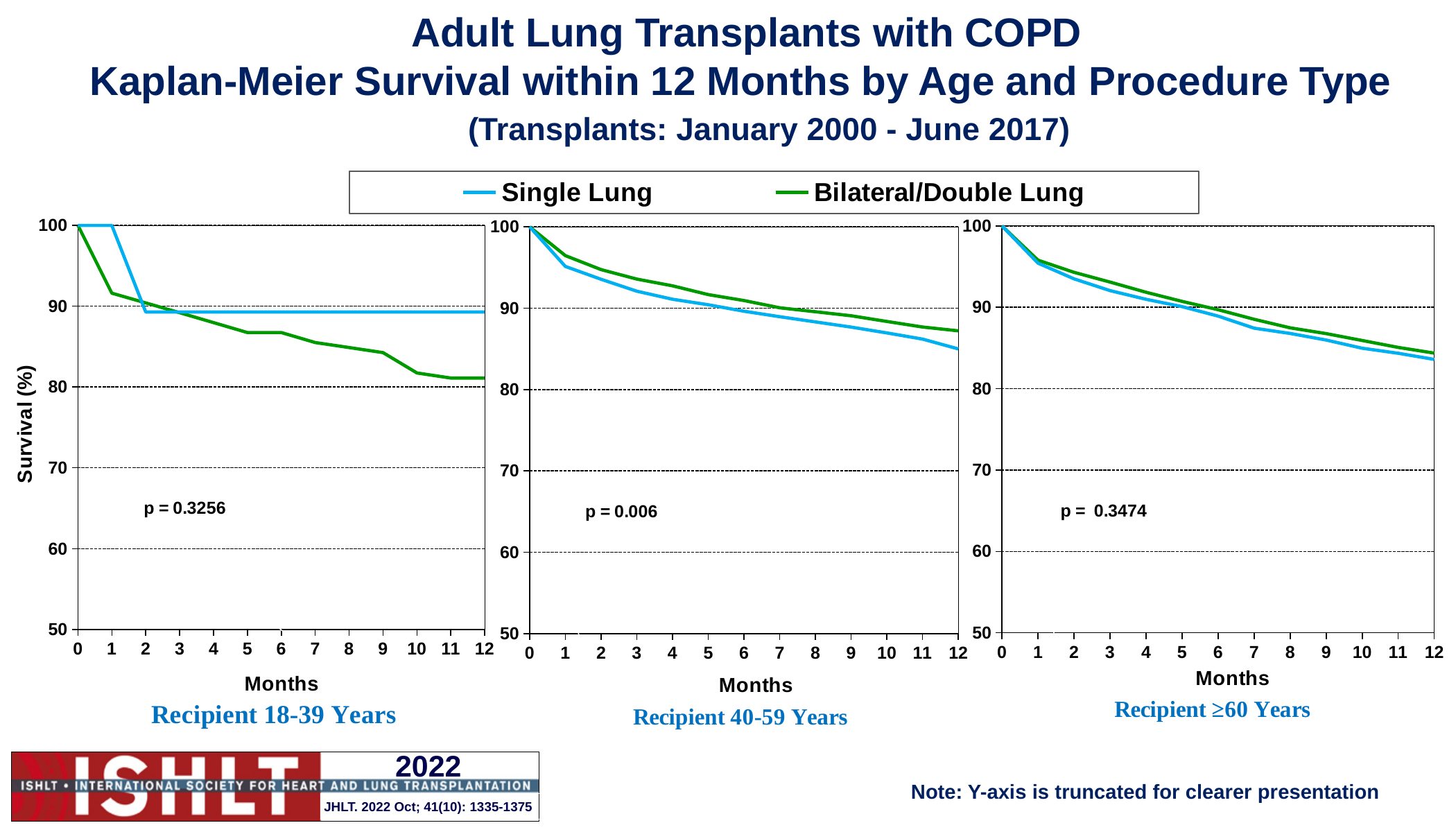
How many series does the legend list? 2 In the 'Recipient 18-39 Years' chart, is the Bilateral/Double Lung value at 12 months greater or less than 90? less In the 'Recipient 18-39 Years' chart, which series has the higher survival at 12 months? Single Lung In the 'Recipient ≥60 Years' chart, is the Single Lung value at 12 months greater or less than 80? greater In the 'Recipient 40-59 Years' chart, which series has the higher survival at 12 months? Bilateral/Double Lung In the 'Recipient 40-59 Years' chart, does the Single Lung survival rise or fall over the 12 months? fall In the 'Recipient 40-59 Years' chart, what p-value is printed? p = 0.006 In the 'Recipient 40-59 Years' chart, what is the survival value for Single Lung at month 0? 100 In the 'Recipient 18-39 Years' chart, is the Single Lung value at 12 months greater or less than 80? greater How many survival charts are shown on the slide? 3 What kind of chart is used in the 'Recipient 40-59 Years' panel? line chart In the 'Recipient 18-39 Years' chart, what p-value is printed? p = 0.3256